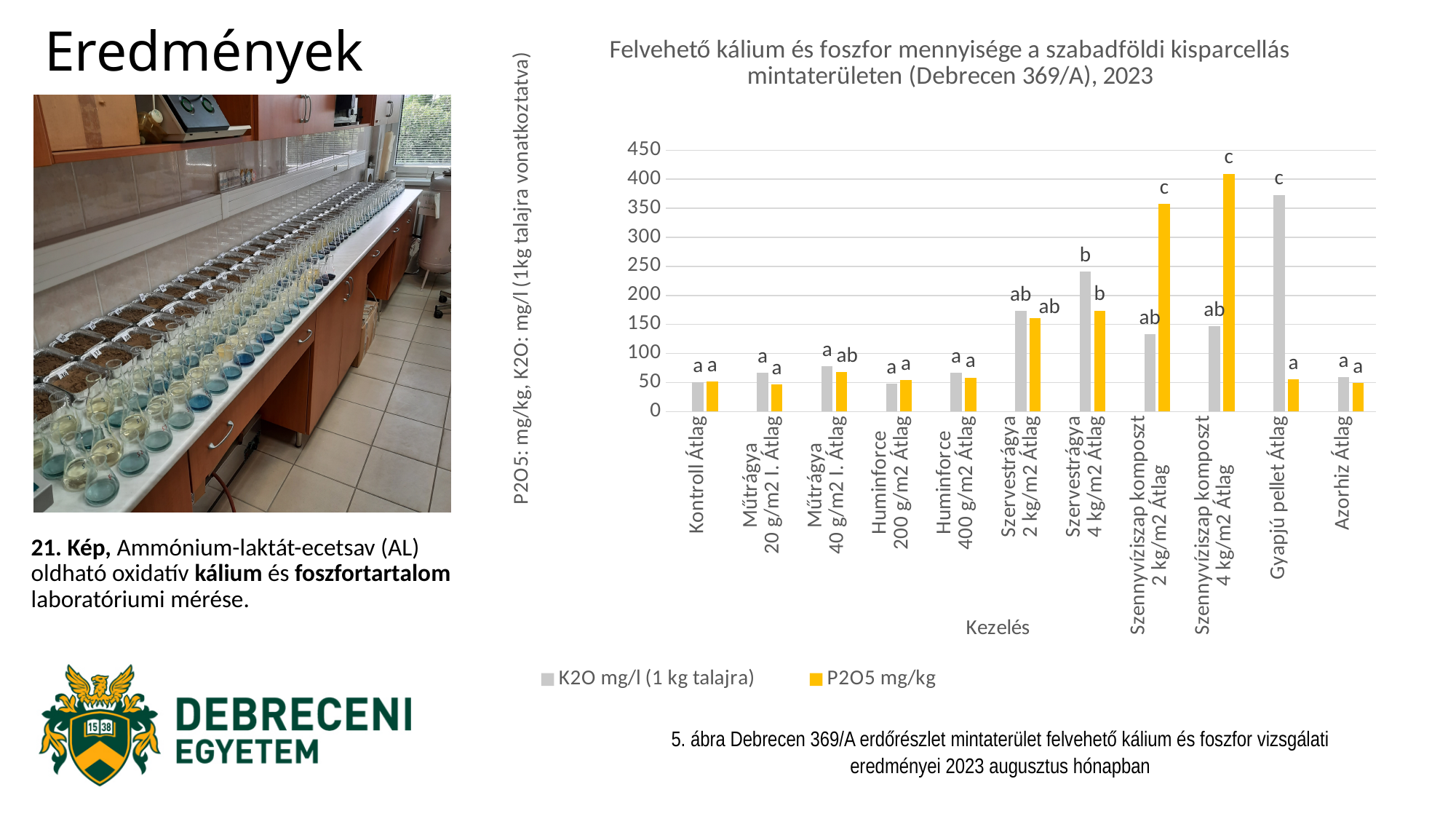
Which treatment has the highest P2O5 mg/kg value? Szennyvíziszap komposzt 4 kg/m2 Átlag For Gyapjú pellet Átlag, which is larger: the K2O value or the P2O5 value? K2O mg/l (1 kg talajra) What is the title of the x axis of the chart? Kezelés Is the K2O mg/l (1 kg talajra) value for Kontroll Átlag greater or less than 100? less How many treatment categories are shown on the x axis of the chart? 11 Is the K2O mg/l (1 kg talajra) value for Szervestrágya 4 kg/m2 Átlag greater or less than 200? greater Which series is shown in yellow in the chart? P2O5 mg/kg For Szennyvíziszap komposzt 2 kg/m2 Átlag, which is larger: the K2O value or the P2O5 value? P2O5 mg/kg Which treatment has the highest K2O mg/l (1 kg talajra) value? Gyapjú pellet Átlag What kind of chart is shown on the slide? bar chart How many series does the chart legend list? 2 Is the P2O5 mg/kg value for Szennyvíziszap komposzt 4 kg/m2 Átlag greater or less than 350? greater